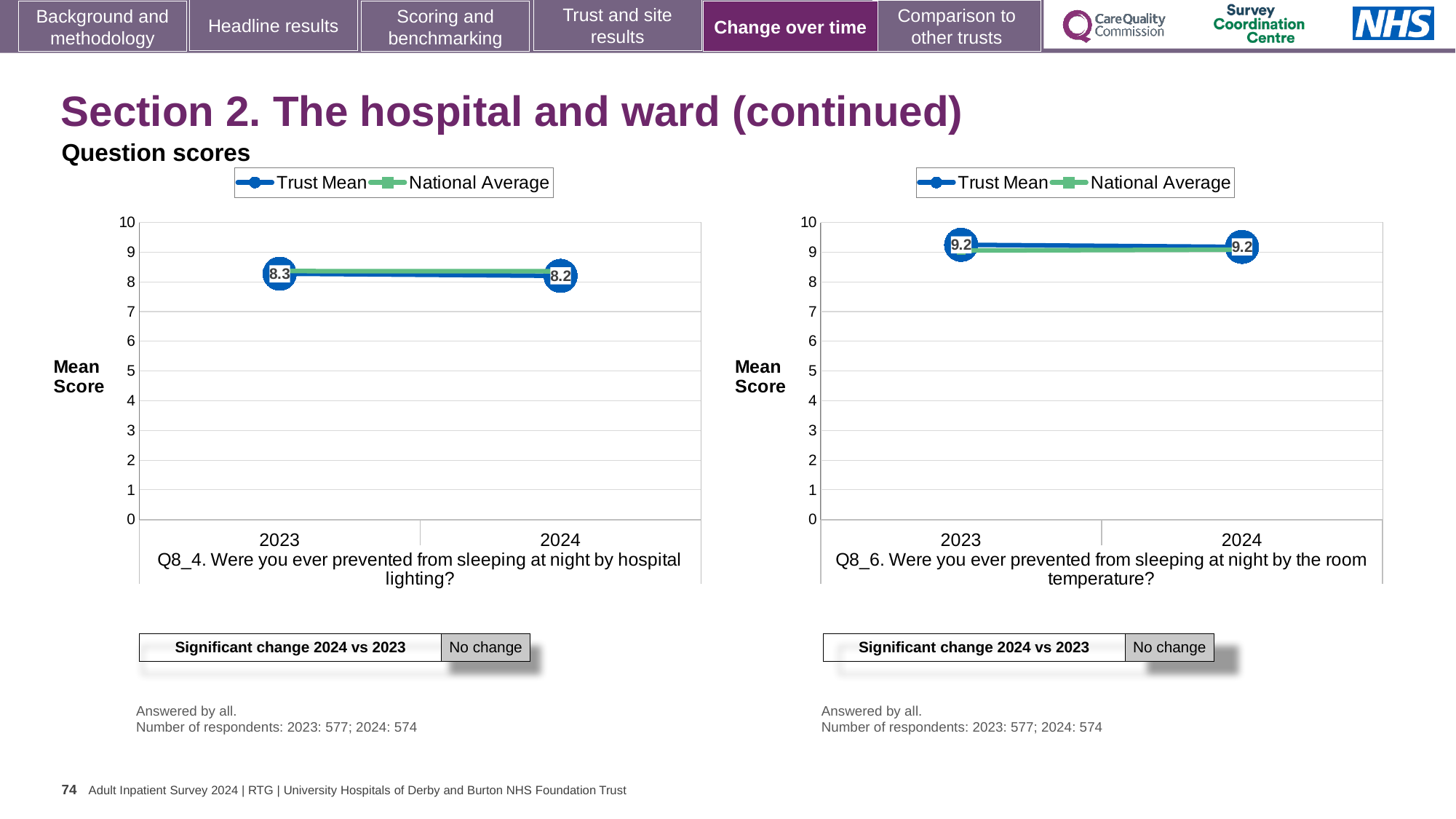
On the right chart (Q8_6, room temperature), what is the Trust Mean score for 2023? 9.2 On the left chart (Q8_4, hospital lighting), by how much did the Trust Mean change from 2023 to 2024? 0.1 Which two series are listed in the legend of the left chart (Q8_4, hospital lighting)? Trust Mean and National Average On the right chart (Q8_6, room temperature), is the National Average for 2024 greater or less than 5? greater On the right chart (Q8_6, room temperature), what is the Trust Mean score for 2024? 9.2 What kind of chart is used on the left (Q8_4, hospital lighting)? line chart On the left chart (Q8_4, hospital lighting), what is the Trust Mean score for 2024? 8.2 On the left chart (Q8_4, hospital lighting), what is the Trust Mean score for 2023? 8.3 How many years are shown on the x axis of the left chart (Q8_4, hospital lighting)? 2 How many series does the legend of the right chart (Q8_6, room temperature) list? 2 What does the 'Significant change 2024 vs 2023' box below the right chart (Q8_6, room temperature) say? No change On the left chart (Q8_4, hospital lighting), does the Trust Mean rise or fall from 2023 to 2024? fall